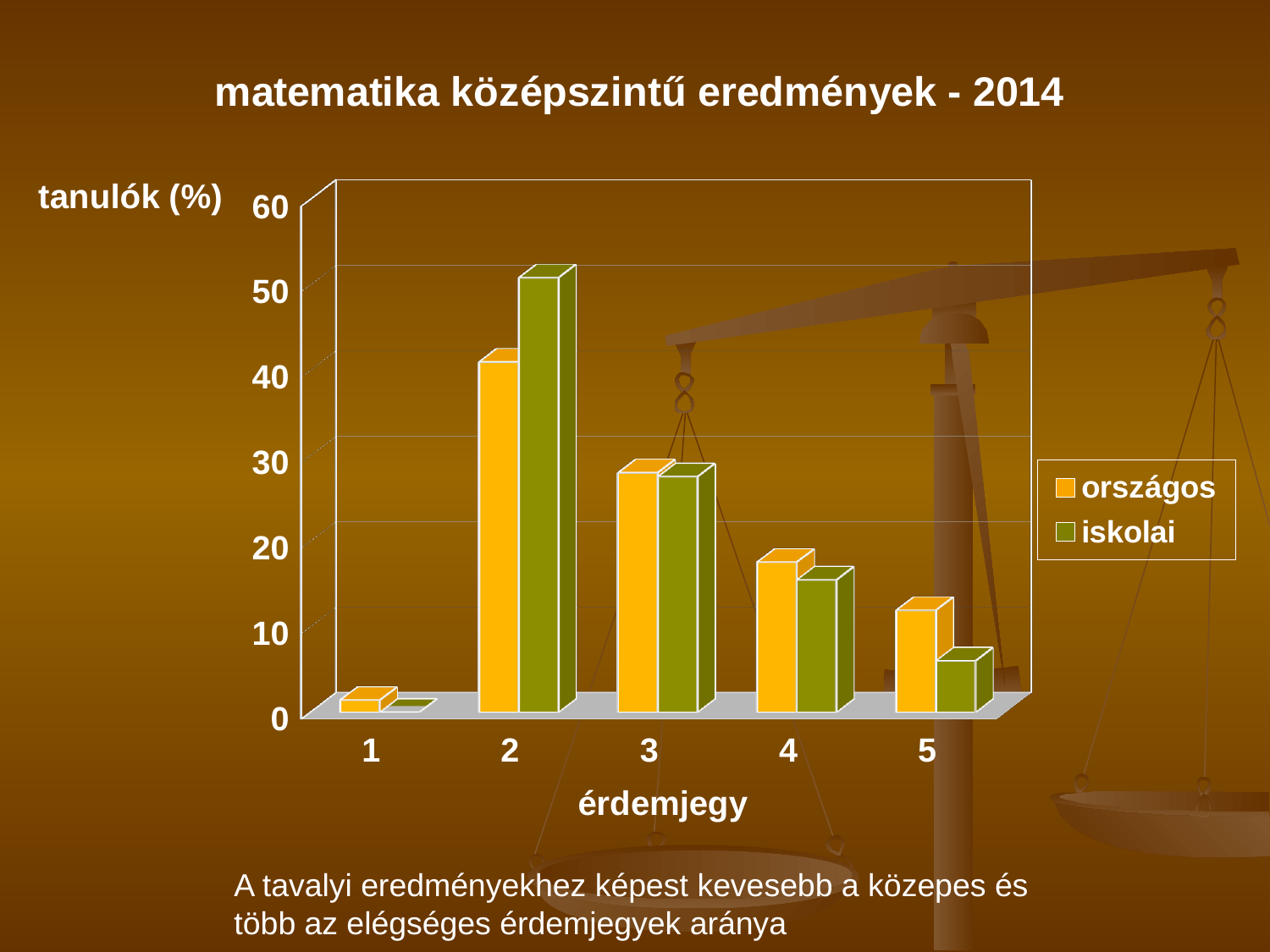
For which érdemjegy is the iskolai value highest? 2 What is the title of the chart? matematika középszintű eredmények - 2014 Is the iskolai value for érdemjegy 2 greater or less than 40? greater What kind of chart is shown on the slide? bar chart How many categories (érdemjegy values) are shown on the x axis? 5 How many series does the legend list? 2 Is the iskolai value for érdemjegy 5 greater or less than 10? less For érdemjegy 5, which series has the larger value, országos or iskolai? országos What are the two series named in the legend? országos, iskolai For which érdemjegy is the országos value lowest? 1 For which érdemjegy is the országos value highest? 2 For érdemjegy 2, which series has the larger value, országos or iskolai? iskolai